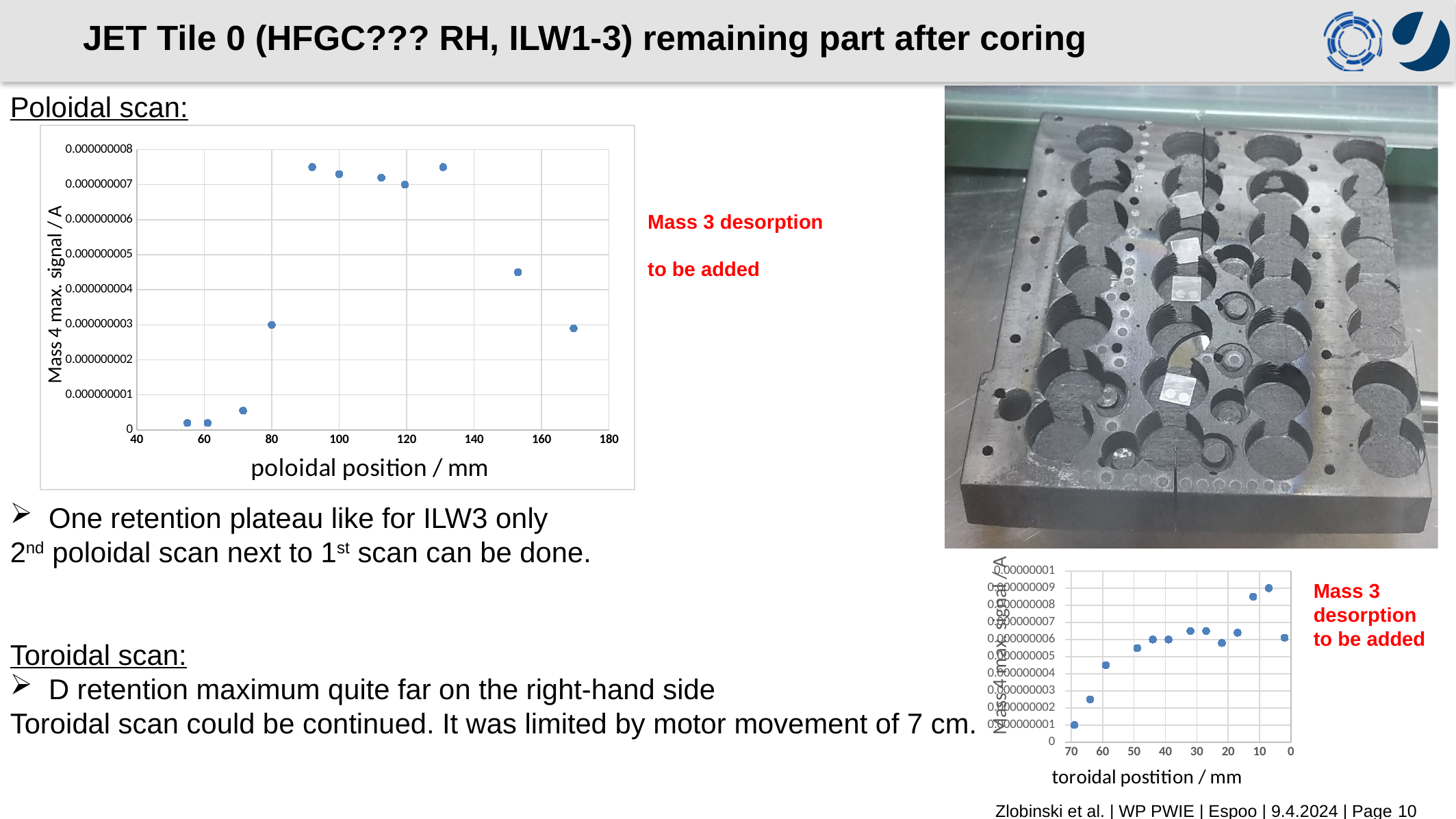
What type of chart is the Poloidal scan chart? scatter chart In the Poloidal scan chart, is the value at a poloidal position of about 92 mm greater or less than 0.000000007? greater In the Poloidal scan chart, is the value at a poloidal position of about 153 mm greater or less than 0.000000004? greater In the Poloidal scan chart, how many data points are plotted? 11 In the Poloidal scan chart, do the values rise or fall as the poloidal position increases from about 55 mm to about 92 mm? rise What is the x-axis title of the Toroidal scan chart? toroidal position / mm In the Poloidal scan chart, is the value at a poloidal position of about 55 mm greater or less than 0.000000001? less What is the x-axis title of the Poloidal scan chart? poloidal position / mm In the Poloidal scan chart, which has the larger value: the point at about 80 mm or the point at about 153 mm? the point at about 153 mm